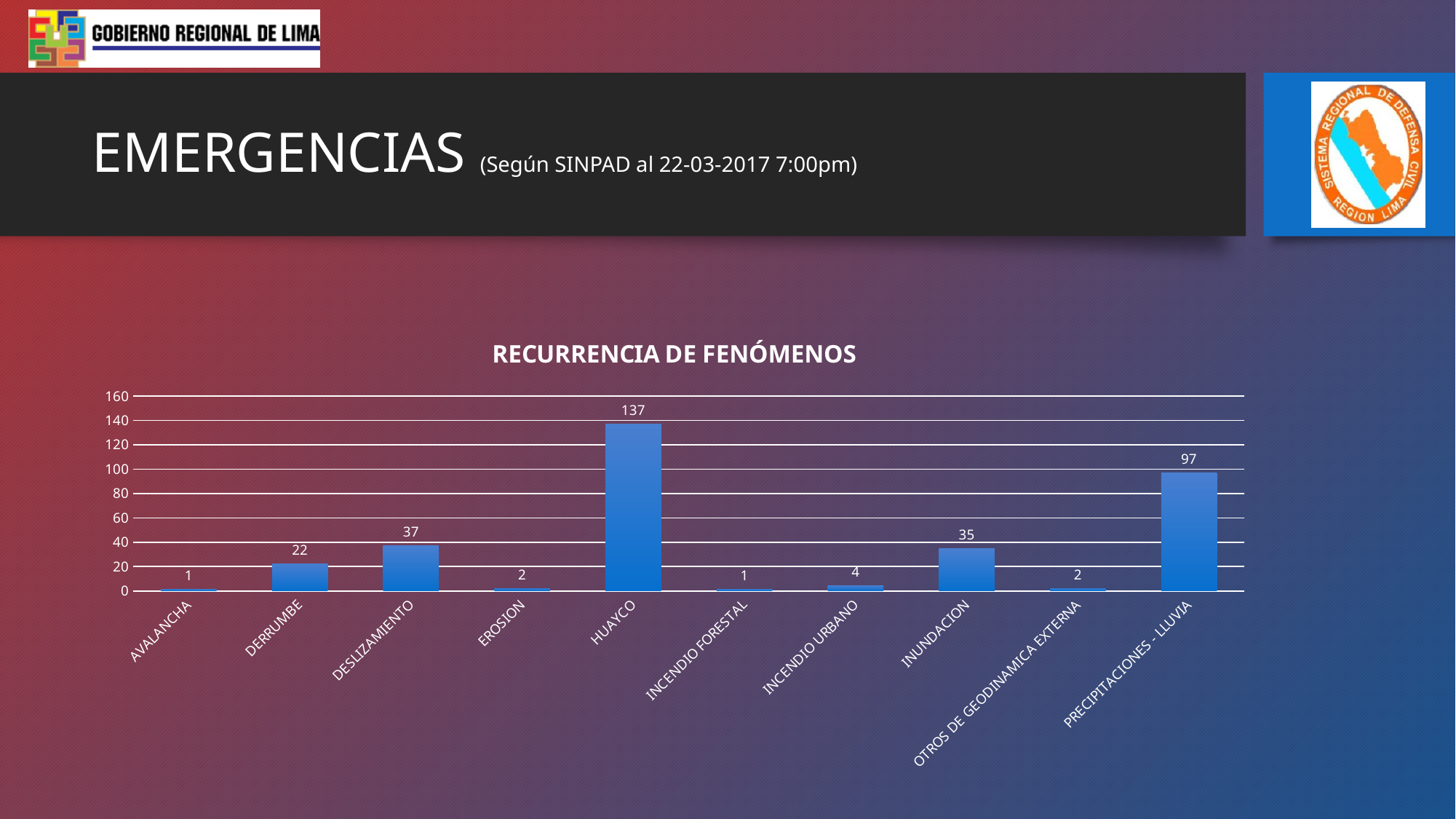
Which is larger, the value for DERRUMBE or the value for INUNDACION? INUNDACION Which category has the highest value? HUAYCO What is the value for DESLIZAMIENTO? 37 What is the difference between the values for DESLIZAMIENTO and DERRUMBE? 15 What is the value for HUAYCO? 137 What is the difference between the values for HUAYCO and PRECIPITACIONES - LLUVIA? 40 What is the value for PRECIPITACIONES - LLUVIA? 97 Is the value for HUAYCO greater or less than 120? greater What is the title of the chart? RECURRENCIA DE FENÓMENOS What kind of chart is shown? bar chart How many categories are shown on the x axis? 10 What is the value for INUNDACION? 35